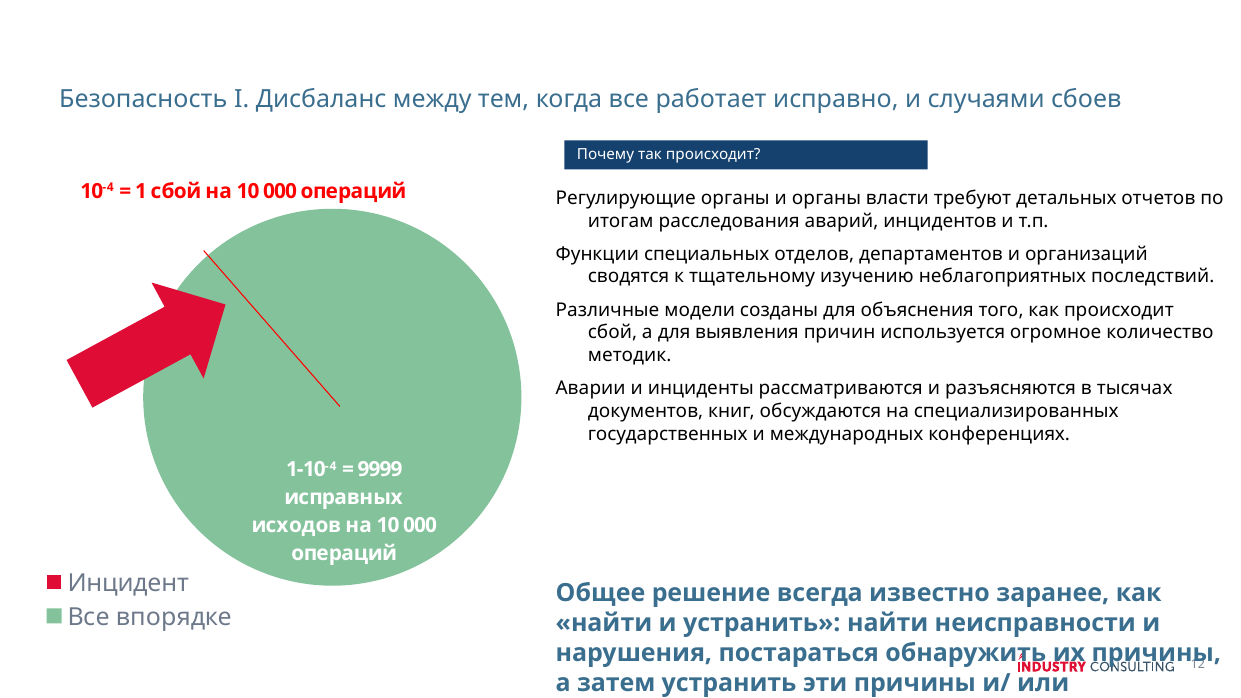
What kind of chart is shown on the slide? Pie chart What is the difference between the number of correct outcomes (9999) and the number of failures (1) per 10 000 operations shown on the pie chart? 9998 Which category takes up the largest share of the pie chart? Все впорядке What is the total number of operations represented by the two slices of the pie chart (9999 + 1)? 10 000 According to the label inside the green slice, how many correct outcomes (исправных исходов) are there per 10 000 operations? 9999 What colour represents the category Инцидент in the pie chart? Red Which is larger in the pie chart: the share for Инцидент or the share for Все впорядке? Все впорядке How many categories does the pie chart's legend list? 2 According to the label on the pie chart, how many failures (сбой) occur per 10 000 operations? 1 сбой на 10 000 операций Which category takes up the smallest share of the pie chart? Инцидент What colour represents the category Все впорядке in the pie chart? Green